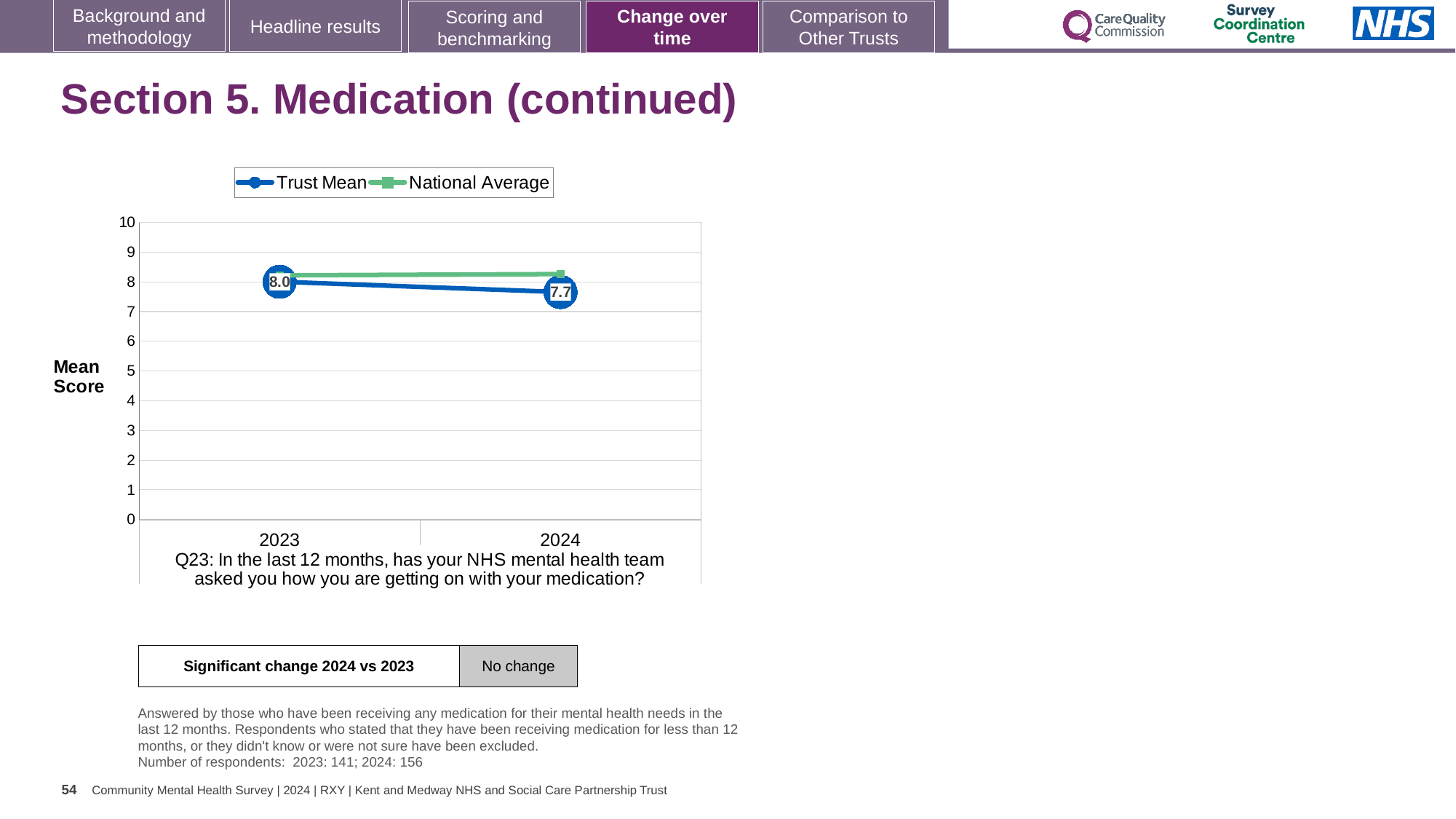
What are the two series named in the legend? Trust Mean and National Average By how much did the Trust Mean fall from 2023 to 2024? 0.3 How many series does the legend list? 2 What is the Trust Mean value for 2024? 7.7 Which year has the higher Trust Mean, 2023 or 2024? 2023 What is the label on the y axis of the chart? Mean Score How many years are plotted on the x axis? 2 What kind of chart is shown on the slide? line chart Is the National Average value for 2024 greater or less than 7? greater Does the Trust Mean rise or fall from 2023 to 2024? fall In 2024, which is higher, the Trust Mean or the National Average? National Average What is the Trust Mean value for 2023? 8.0